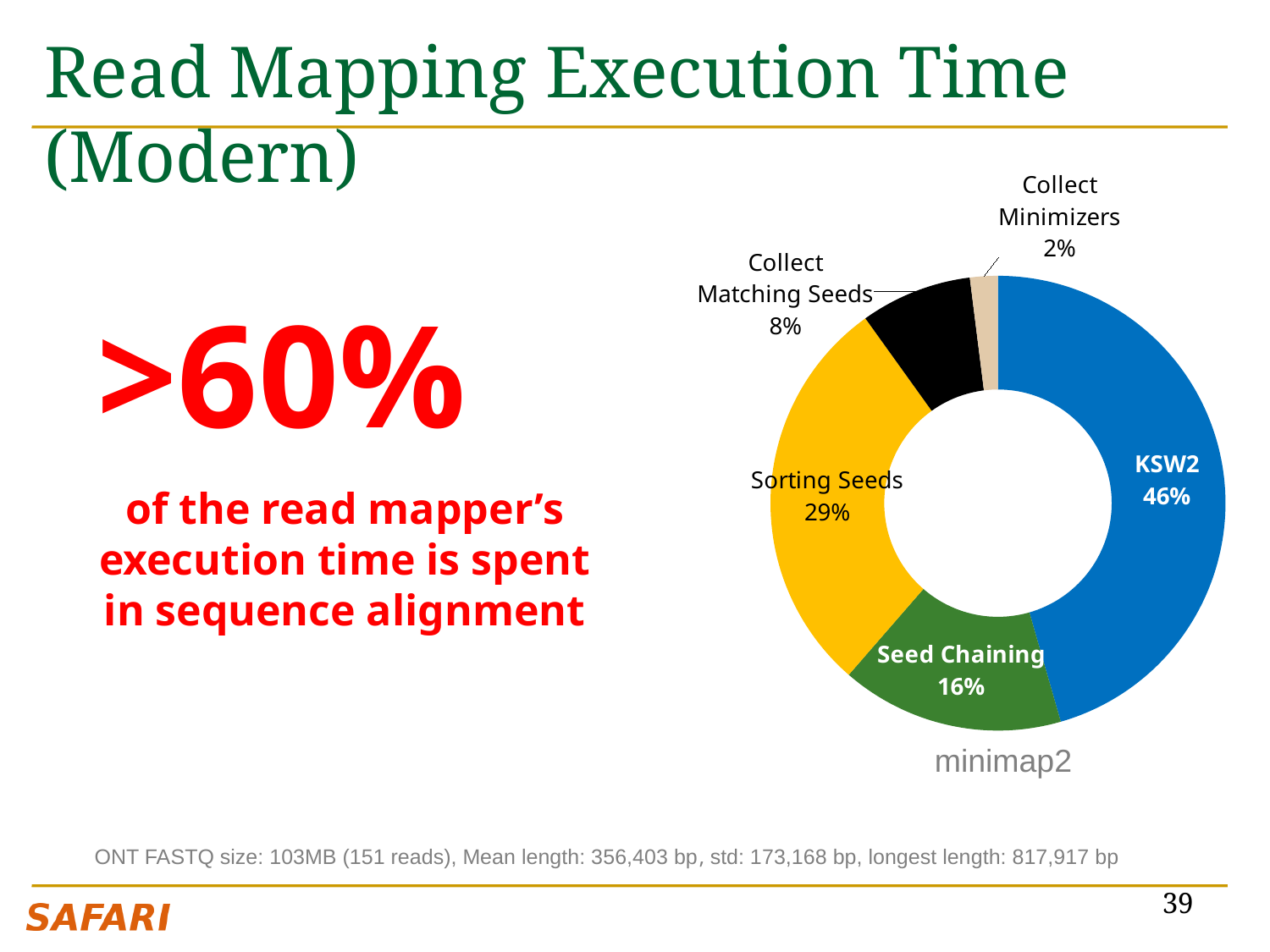
Which stage takes the largest share of execution time? KSW2 What percentage of execution time is spent on Collect Matching Seeds? 8% What percentage of execution time is spent on Collect Minimizers? 2% What percentage of execution time is spent on Seed Chaining? 16% What kind of chart is shown on the slide? Pie chart (doughnut) How many stages are shown in the chart? 5 What share of execution time does KSW2 take in the minimap2 chart? 46% What is the difference in percentage points between KSW2 and Sorting Seeds? 17 Which stage takes the smallest share of execution time? Collect Minimizers Which read mapper is the chart labelled with? minimap2 Which takes a larger share of execution time, Seed Chaining or Collect Matching Seeds? Seed Chaining What percentage of execution time is spent on Sorting Seeds? 29%